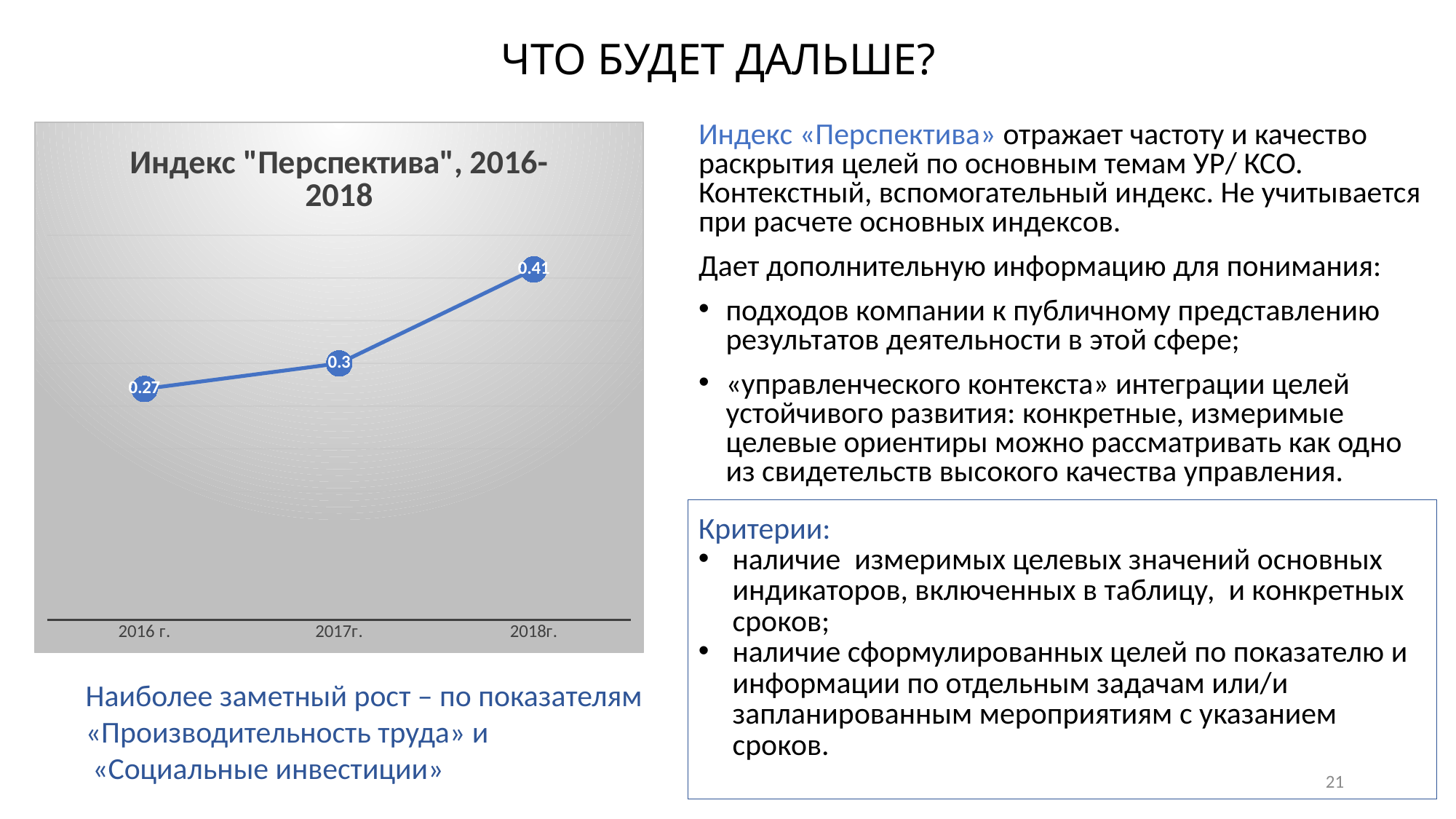
Which year has the lowest index value? 2016 г. How many data points are plotted on the chart? 3 Which is larger, the index value for 2017г. or for 2018г.? 2018г. What is the difference between the index values for 2018г. and 2016 г.? 0.14 What is the title of the chart? Индекс "Перспектива", 2016-2018 What is the value of the index for 2018г.? 0.41 What is the value of the index for 2016 г.? 0.27 What is the value of the index for 2017г.? 0.3 What kind of chart is shown on the slide? line chart What is the difference between the index values for 2017г. and 2016 г.? 0.03 Do the index values rise or fall from 2016 г. to 2018г.? rise Which year has the highest index value? 2018г.